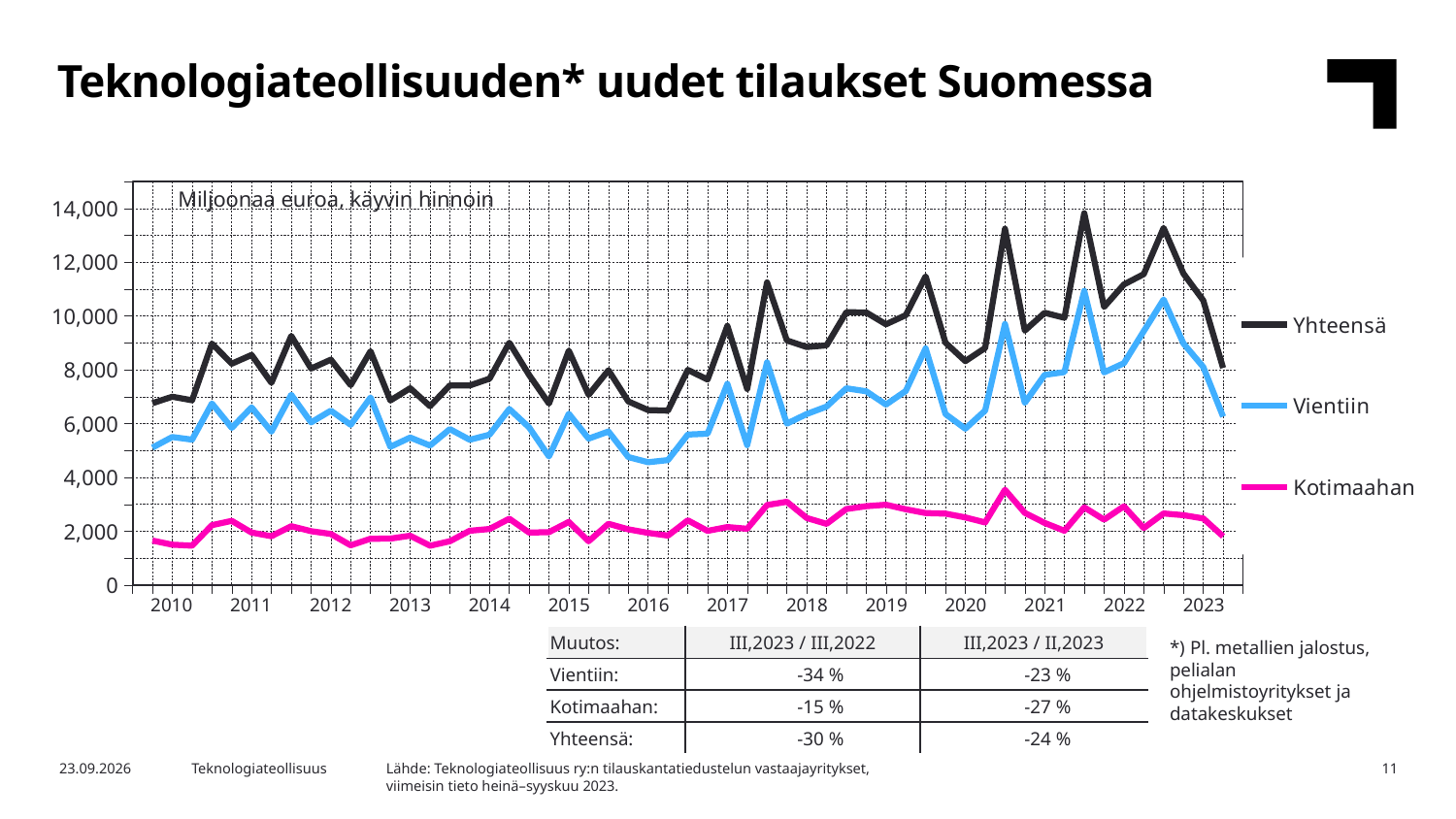
Does the Kotimaahan series generally rise or fall from 2010 to 2018? rise Is the value of the Yhteensä series at the start of 2010 greater or less than 8,000? less Which series is larger in 2019, Vientiin or Kotimaahan? Vientiin Which series has the lowest values throughout the chart? Kotimaahan How many year labels appear on the x axis of the chart? 14 Which series has the highest values throughout the chart? Yhteensä Is the peak value of the Yhteensä series in 2021 greater or less than 12,000? greater What unit label is printed inside the chart area? Miljoonaa euroa, käyvin hinnoin What are the three series named in the chart legend? Yhteensä, Vientiin, Kotimaahan Is the highest value of the Kotimaahan series greater or less than 4,000? less How many series does the chart legend list? 3 What kind of chart is shown on the slide? line chart